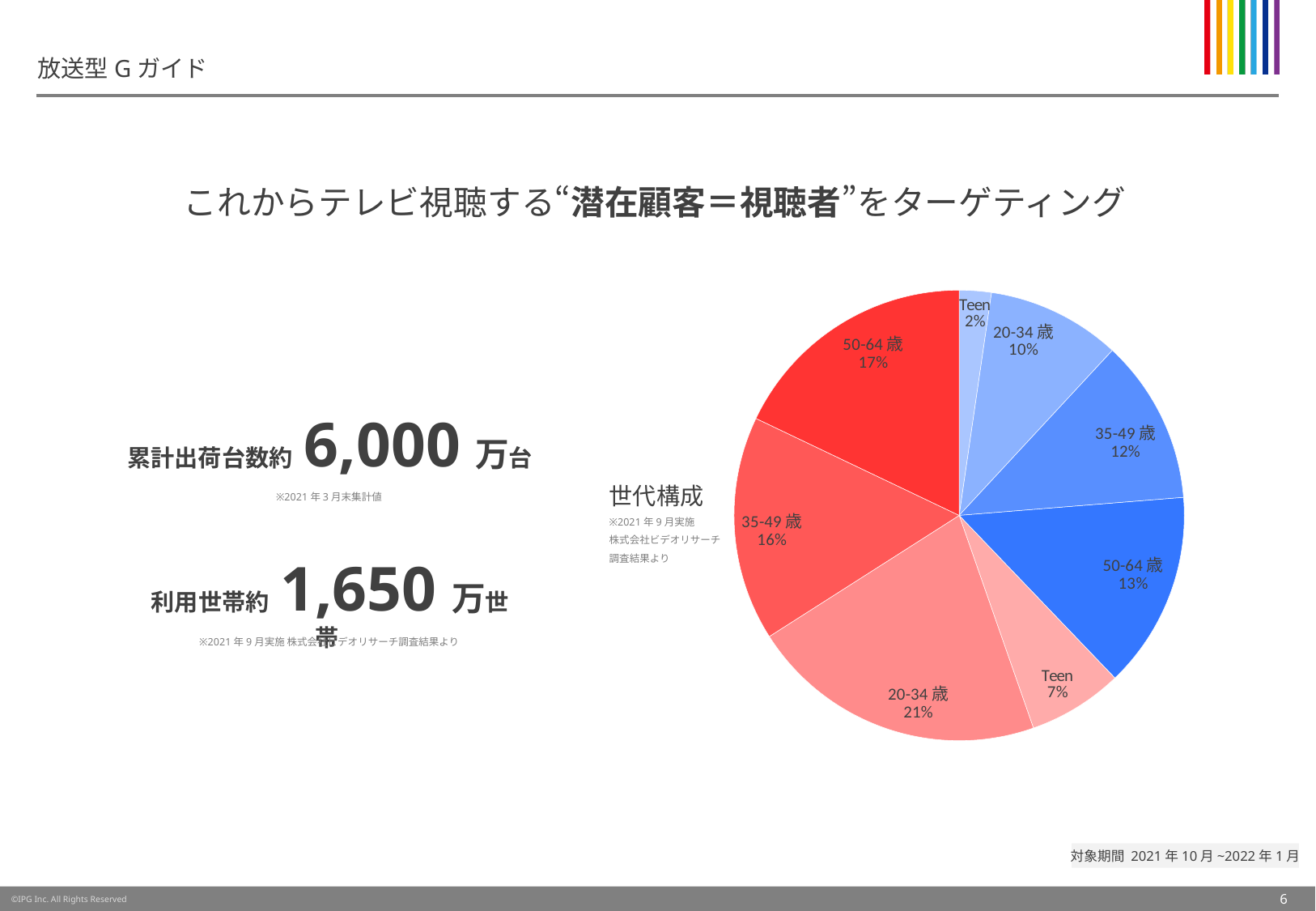
Which slice of the pie chart is the largest? 20-34歳 (red/pink), 21% What percentage is shown for the blue 50-64歳 slice? 13% How many slices does the pie chart have? 8 What percentage is shown for the red 35-49歳 slice? 16% What percentage is shown for the red Teen slice? 7% Which is larger: the blue 35-49歳 slice or the red Teen slice? blue 35-49歳 Which slice of the pie chart is the smallest? Teen (blue), 2% What is the difference between the red 50-64歳 slice and the blue 50-64歳 slice? 4 percentage points What kind of chart is shown on the slide? pie chart What percentage is shown for the blue 20-34歳 slice? 10% What is the combined share of the four blue slices? 37% What is the title of the pie chart? 世代構成